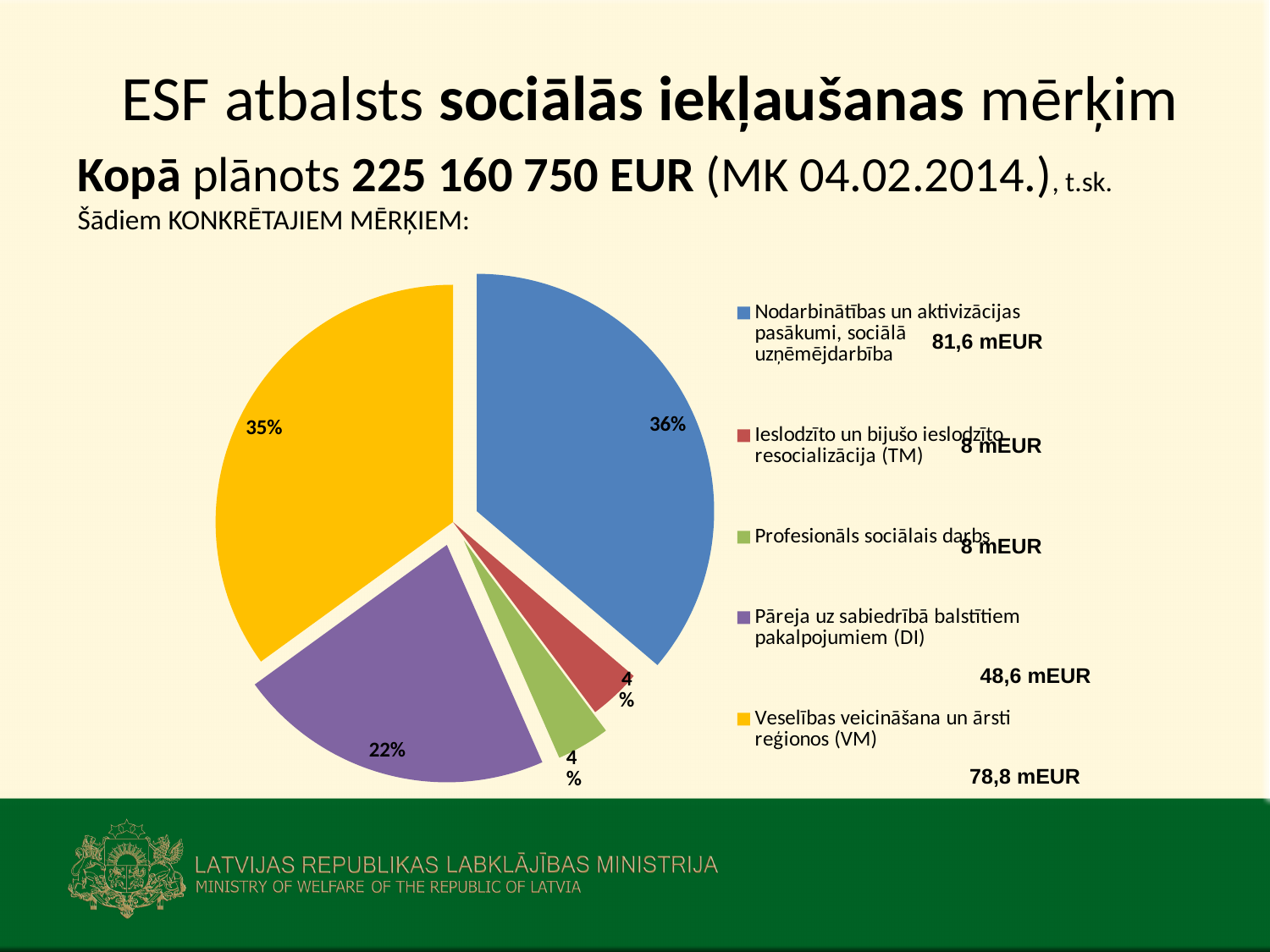
What share of the pie does 'Profesionāls sociālais darbs' have? 4% What share of the pie does 'Pāreja uz sabiedrībā balstītiem pakalpojumiem (DI)' have? 22% How many entries does the legend of the pie chart list? 5 What colour is the slice for 'Ieslodzīto un bijušo ieslodzīto resocializācija (TM)'? red Which slice is larger: 'Nodarbinātības un aktivizācijas pasākumi, sociālā uzņēmējdarbība' or 'Veselības veicināšana un ārsti reģionos (VM)'? Nodarbinātības un aktivizācijas pasākumi, sociālā uzņēmējdarbība What share of the pie does 'Veselības veicināšana un ārsti reģionos (VM)' have? 35% What is the difference in percentage points between the 'Veselības veicināšana un ārsti reģionos (VM)' slice and the 'Pāreja uz sabiedrībā balstītiem pakalpojumiem (DI)' slice? 13 percentage points How many slices does the pie chart have? 5 What colour is the slice for 'Pāreja uz sabiedrībā balstītiem pakalpojumiem (DI)'? purple What kind of chart is shown on the slide? pie chart Which category has the largest slice of the pie chart? Nodarbinātības un aktivizācijas pasākumi, sociālā uzņēmējdarbība